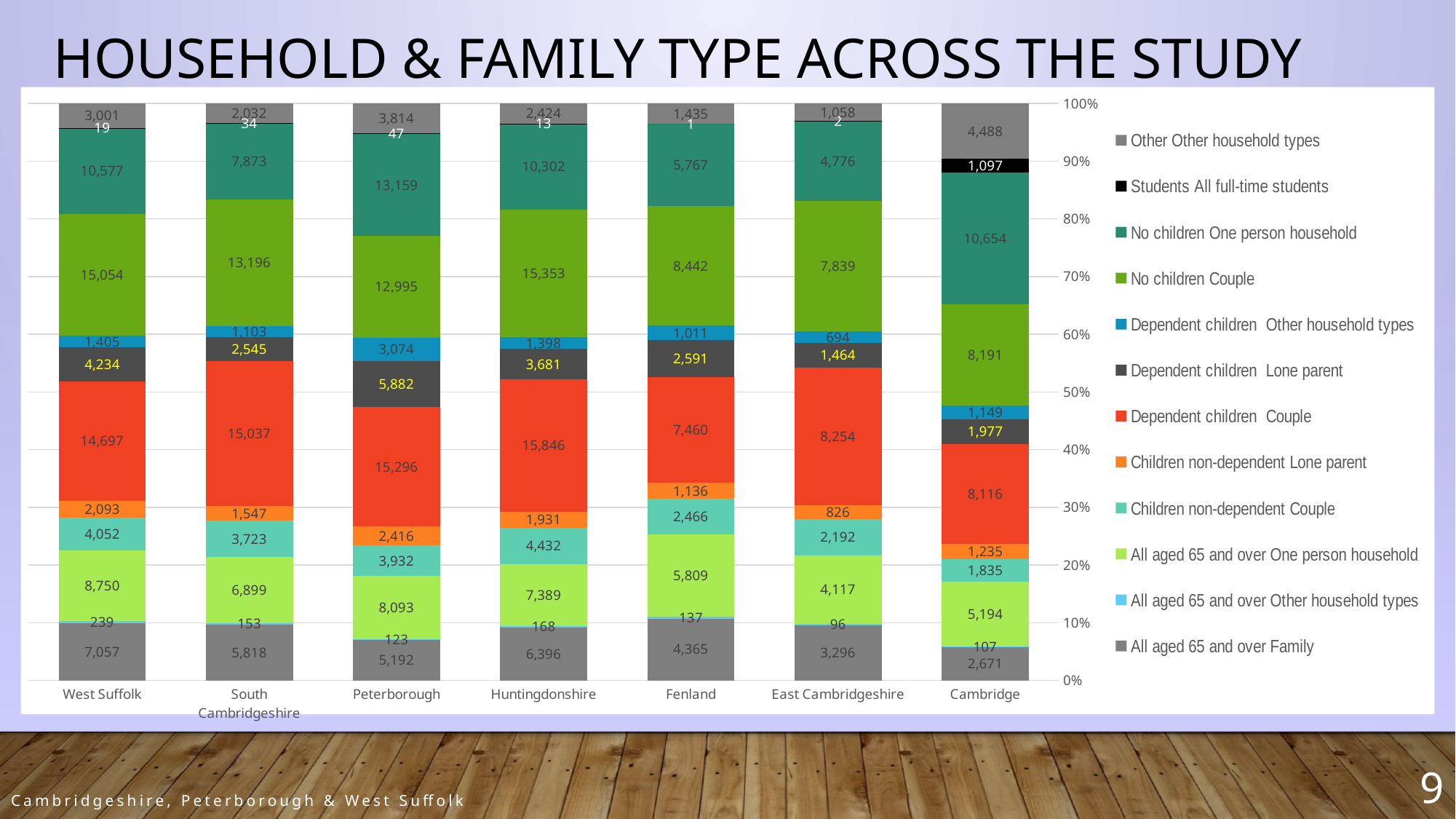
How many areas are shown on the x axis? 7 What is the value for No children Couple in West Suffolk? 15,054 What is the value for Dependent children Couple in Huntingdonshire? 15,846 What is the value for All aged 65 and over Family in Fenland? 4,365 What is the difference between the No children Couple values for West Suffolk and South Cambridgeshire? 1,858 What is the value for Students All full-time students in Cambridge? 1,097 What kind of chart is shown on the slide? Stacked bar chart Which area has the lowest value for No children One person household? East Cambridgeshire Which area has the highest value for Dependent children Couple? Huntingdonshire In Cambridge, what is the difference between the Other household types value and the Students value? 3,391 Which has the larger Dependent children Lone parent value, Peterborough or Huntingdonshire? Peterborough How many series does the legend list? 12